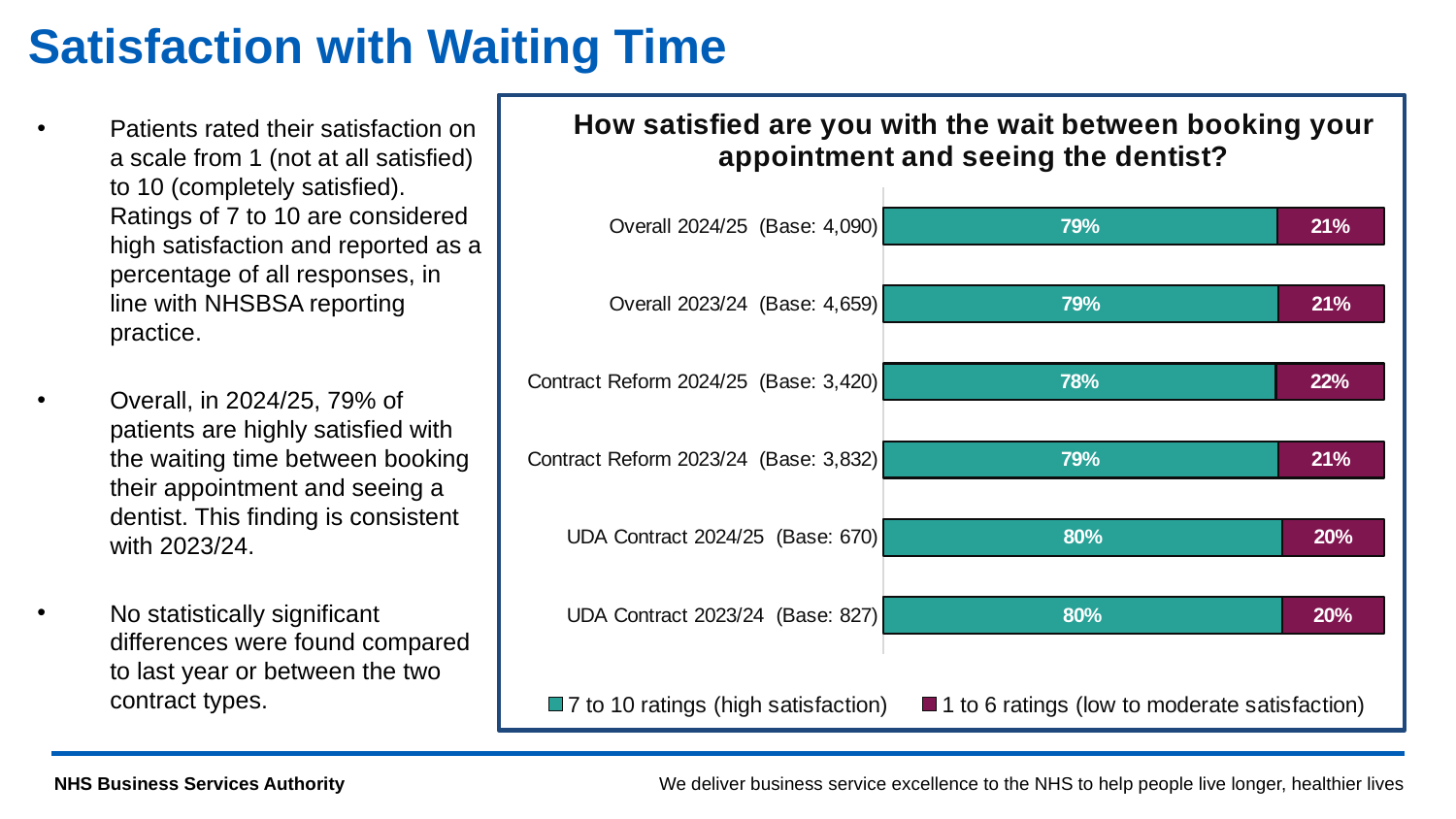
What is the difference in high satisfaction (7 to 10 ratings) between UDA Contract 2024/25 and Contract Reform 2024/25? 2 percentage points What percentage of UDA Contract 2023/24 respondents gave 1 to 6 ratings (low to moderate satisfaction)? 20% How many series does the legend list? 2 What is the high satisfaction (7 to 10 ratings) percentage for Contract Reform 2024/25? 78% Which category has the highest percentage of 1 to 6 ratings (low to moderate satisfaction)? Contract Reform 2024/25 Which category has the lowest percentage of 7 to 10 ratings (high satisfaction)? Contract Reform 2024/25 What is the total of the two segments for the Overall 2024/25 bar? 100% What percentage of Overall 2024/25 respondents gave 7 to 10 ratings (high satisfaction)? 79% How many categories (bars) are shown in the chart? 6 What type of chart is shown on the slide? Stacked bar chart Which has a higher percentage of 7 to 10 ratings: UDA Contract 2024/25 or Contract Reform 2024/25? UDA Contract 2024/25 What is the base size shown for Overall 2023/24? 4,659